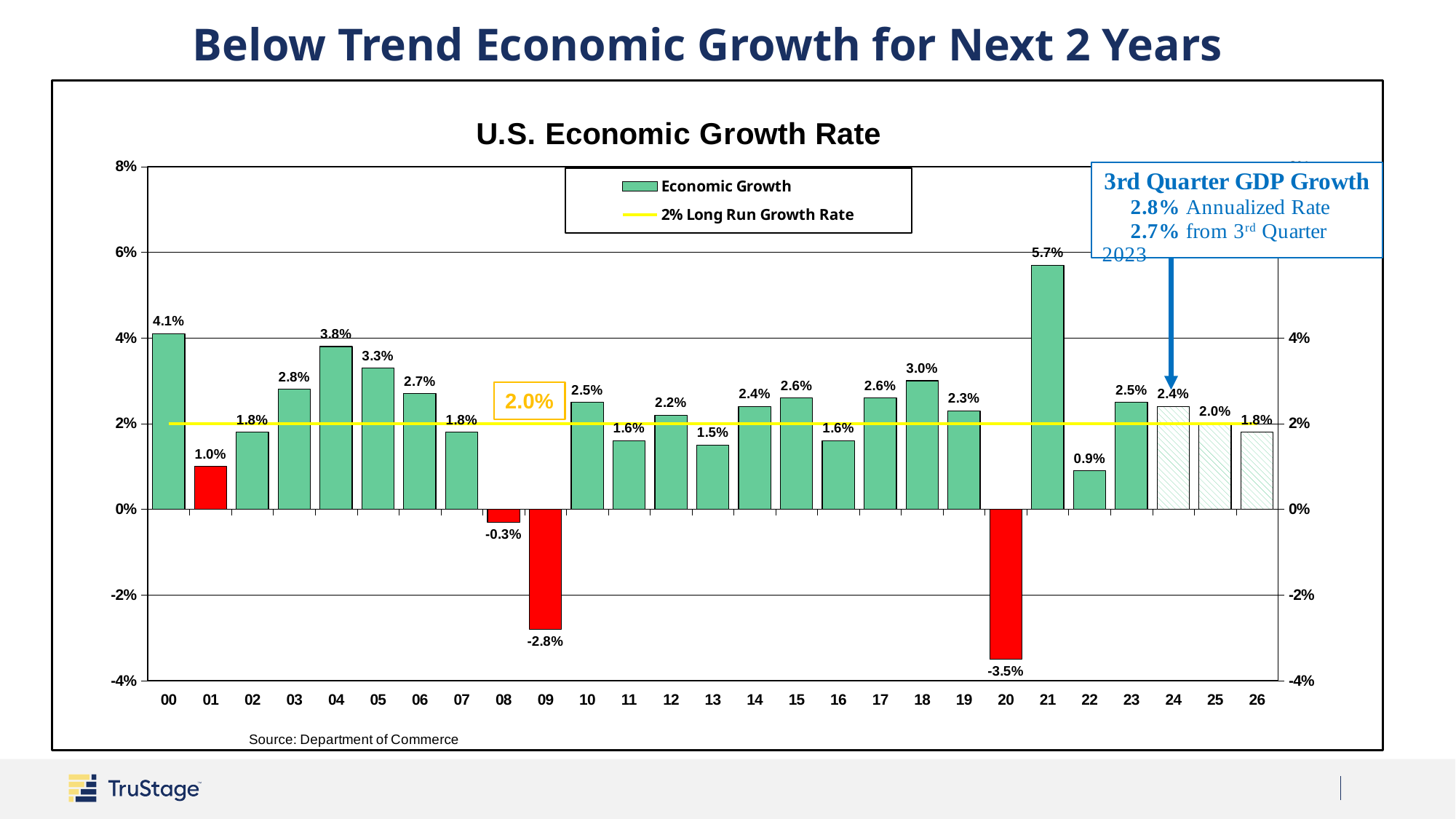
What is the economic growth rate shown for 2024? 2.4% What is the difference between the growth rates for 2000 and 2001? 3.1% How many entries does the legend list? 2 Is the value for 2022 greater or less than 2%? less What is the title of the chart? U.S. Economic Growth Rate What kind of chart is this? combination bar and line chart Which year has the larger growth rate, 2004 or 2005? 04 Which year has the lowest economic growth rate? 20 How many years are shown on the x axis? 27 Which year has the highest economic growth rate? 21 What is the economic growth rate shown for 2021? 5.7% What is the economic growth rate shown for 2009? -2.8%